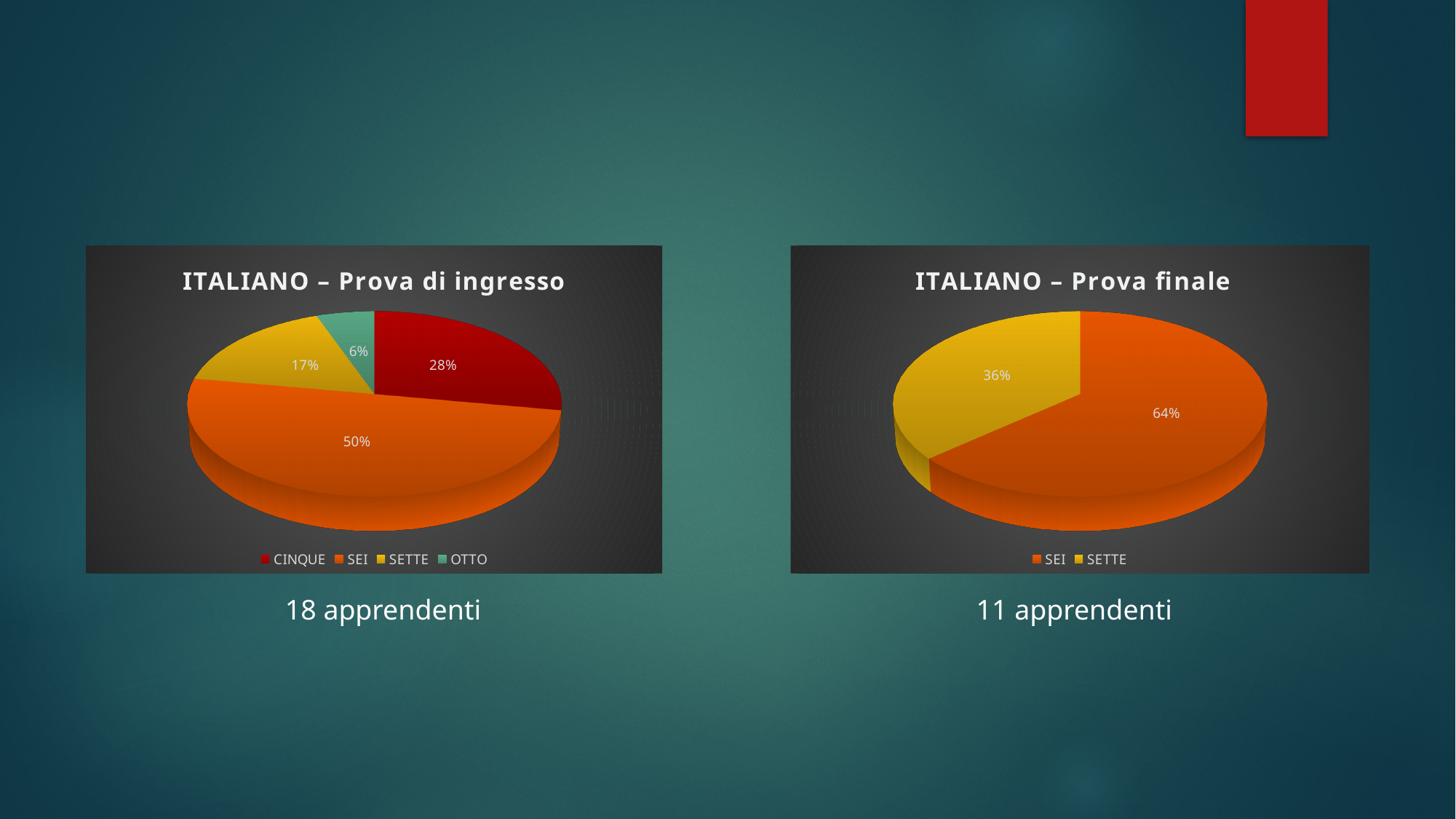
In the 'ITALIANO – Prova finale' chart, what is the difference between the SEI and SETTE shares? 28% In the 'ITALIANO – Prova finale' chart, what share does SETTE have? 36% In the 'ITALIANO – Prova finale' chart, how many categories are shown? 2 In the 'ITALIANO – Prova di ingresso' chart, which category has the largest slice? SEI What kind of chart is 'ITALIANO – Prova finale'? Pie chart In the 'ITALIANO – Prova di ingresso' chart, what is the difference between the SETTE and OTTO shares? 11% In the 'ITALIANO – Prova di ingresso' chart, which category has the smallest slice? OTTO In the 'ITALIANO – Prova di ingresso' chart, what share does CINQUE have? 28% In the 'ITALIANO – Prova di ingresso' chart, how many categories does the legend list? 4 In the 'ITALIANO – Prova finale' chart, which category has the larger slice, SEI or SETTE? SEI In the 'ITALIANO – Prova di ingresso' chart, what share does SEI have? 50%